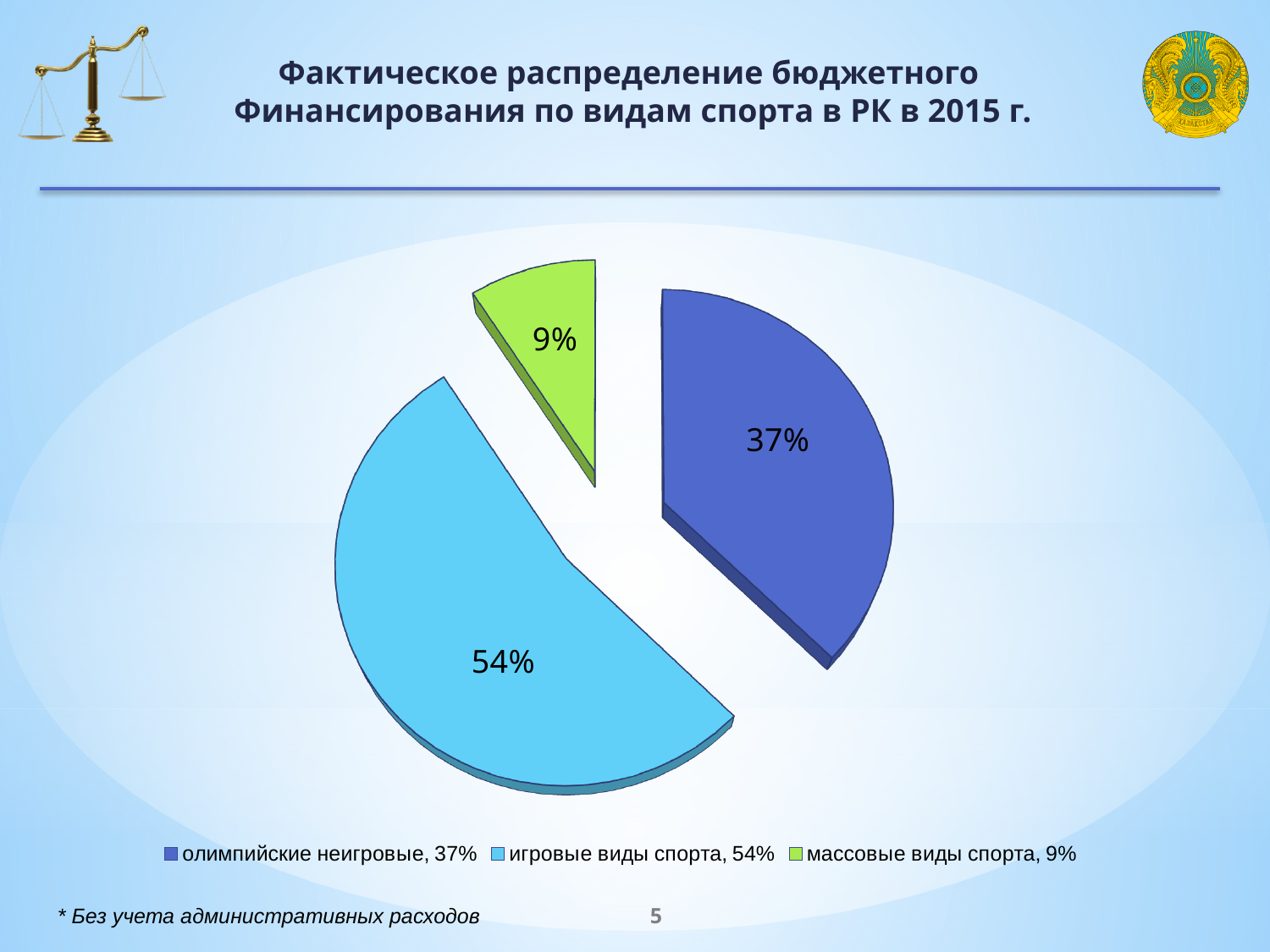
What share of the pie does 'игровые виды спорта' have? 54% Which is larger: the share for 'олимпийские неигровые' or for 'массовые виды спорта'? олимпийские неигровые Which category has the largest slice of the pie? игровые виды спорта What colour is the slice for 'массовые виды спорта'? green What is the difference in percentage points between 'олимпийские неигровые' and 'массовые виды спорта'? 28 What kind of chart is shown on the slide? pie chart How many slices does the pie chart have? 3 What share of the pie does 'олимпийские неигровые' have? 37% Which category has the smallest slice of the pie? массовые виды спорта What share of the pie does 'массовые виды спорта' have? 9% What is the difference in percentage points between 'игровые виды спорта' and 'олимпийские неигровые'? 17 What is the title of the slide containing the chart? Фактическое распределение бюджетного Финансирования по видам спорта в РК в 2015 г.